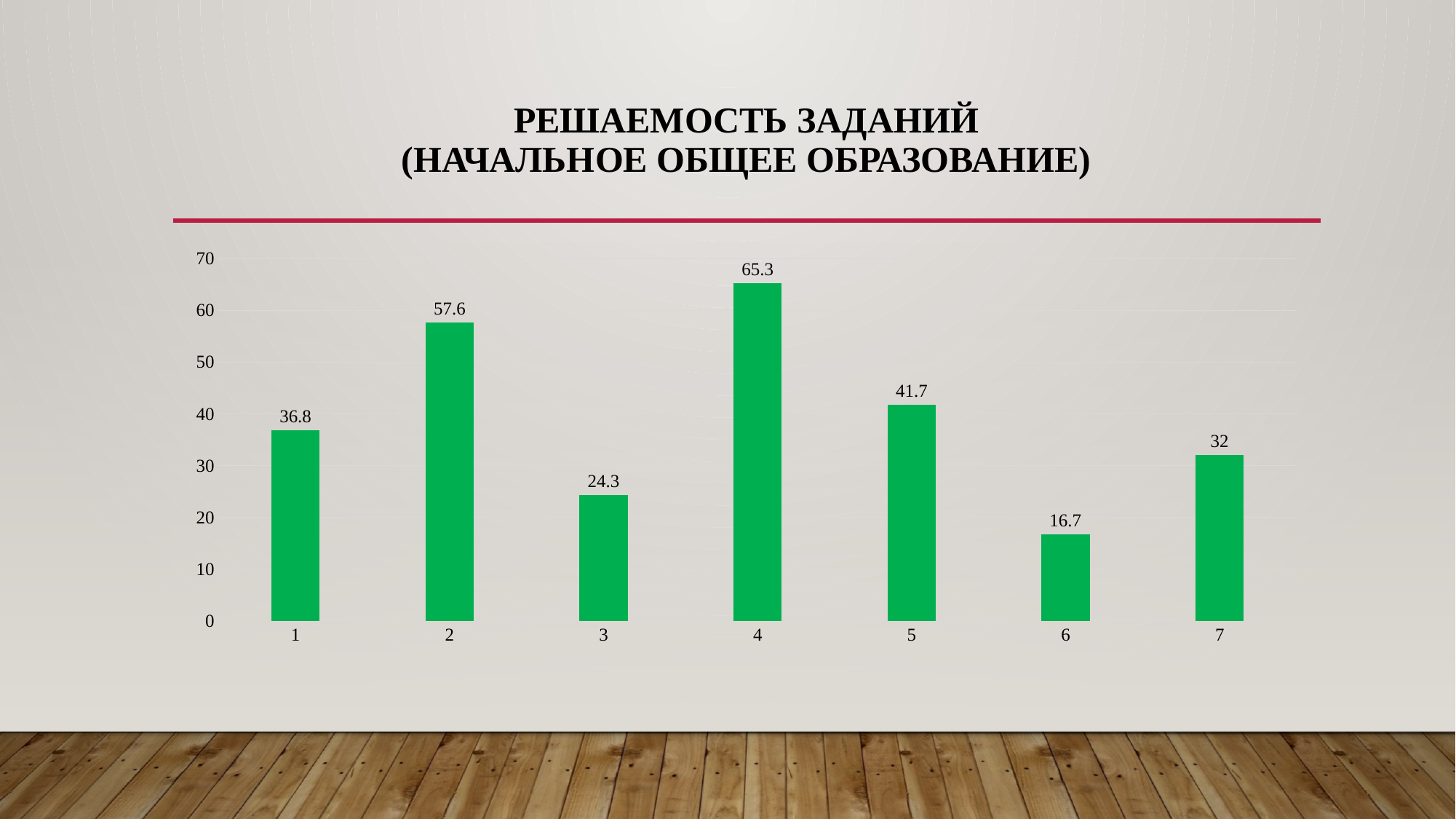
What is the difference between the values for category 4 and category 6? 48.6 Is the value for category 3 greater or less than 30? less Which category has the highest value? 4 What is the value for category 6? 16.7 What is the title of the slide? РЕШАЕМОСТЬ ЗАДАНИЙ (НАЧАЛЬНОЕ ОБЩЕЕ ОБРАЗОВАНИЕ) What is the difference between the values for category 2 and category 1? 20.8 What kind of chart is shown on the slide? bar chart Which is larger, the value for category 5 or the value for category 7? 5 How many categories are shown on the x axis? 7 What is the value for category 4? 65.3 What is the value for category 7? 32 Which category has the lowest value? 6